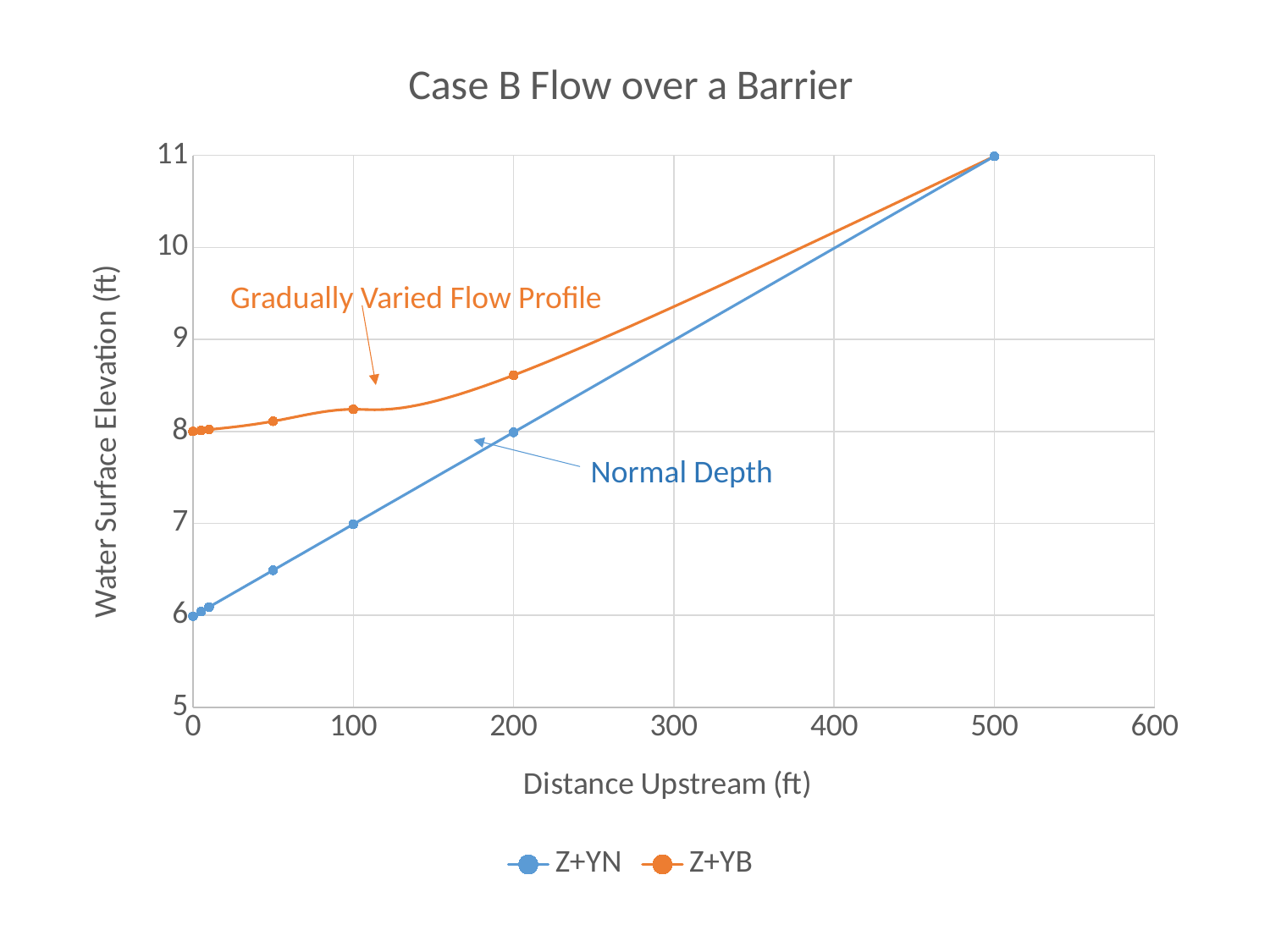
What is the title of the chart? Case B Flow over a Barrier Is the Z+YN value at a distance upstream of 100 ft greater or less than 8? less Is the Z+YB value at a distance upstream of 200 ft greater or less than 8? greater Is the Z+YN value at a distance upstream of 500 ft greater or less than 10? greater How many series does the legend list? 2 Does the Z+YN series rise or fall as distance upstream increases? rise At a distance upstream of 100 ft, which series has the higher water surface elevation, Z+YN or Z+YB? Z+YB At a distance upstream of 200 ft, which series has the higher water surface elevation, Z+YN or Z+YB? Z+YB Which series is drawn in orange? Z+YB What kind of chart is shown on the slide? line chart